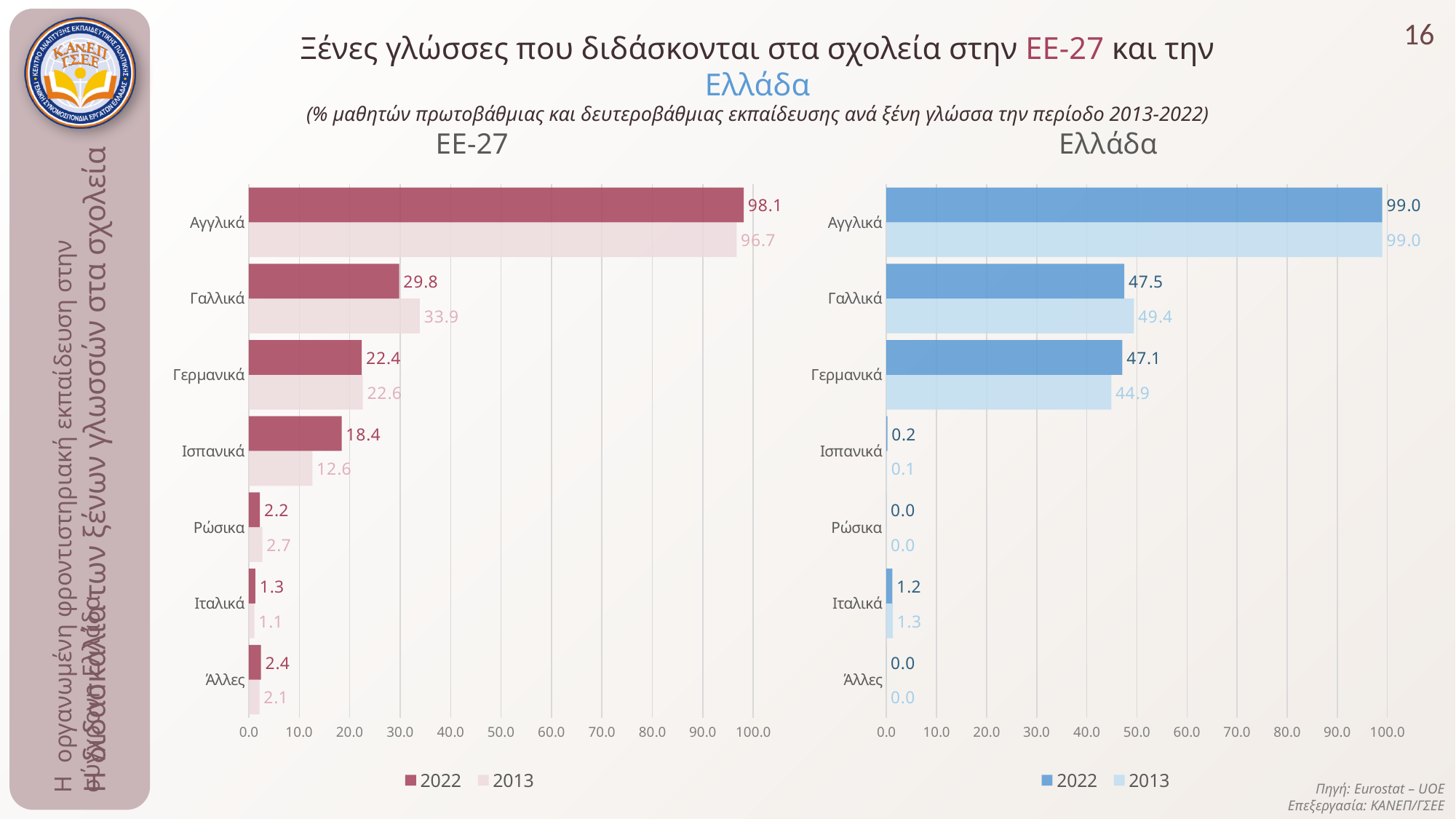
In the Ελλάδα chart, which language has the highest value in 2022? Αγγλικά In the EE-27 chart, is the 2022 value for Γαλλικά greater or less than 20.0? greater How many series does the legend of the EE-27 chart list? 2 How many languages are listed in the Ελλάδα chart? 7 In the Ελλάδα chart, what is the difference between the 2022 and 2013 values for Γερμανικά? 2.2 In the Ελλάδα chart, which is larger for Γαλλικά: the 2022 value or the 2013 value? 2013 In the EE-27 chart, what is the value for Αγγλικά in 2022? 98.1 In the EE-27 chart, what is the difference between the 2013 and 2022 values for Γαλλικά? 4.1 In the EE-27 chart, which language has the lowest value in 2022? Ιταλικά What kind of chart is the Ελλάδα chart? Bar chart In the Ελλάδα chart, what is the value for Γερμανικά in 2013? 44.9 In the EE-27 chart, what is the value for Ισπανικά in 2013? 12.6